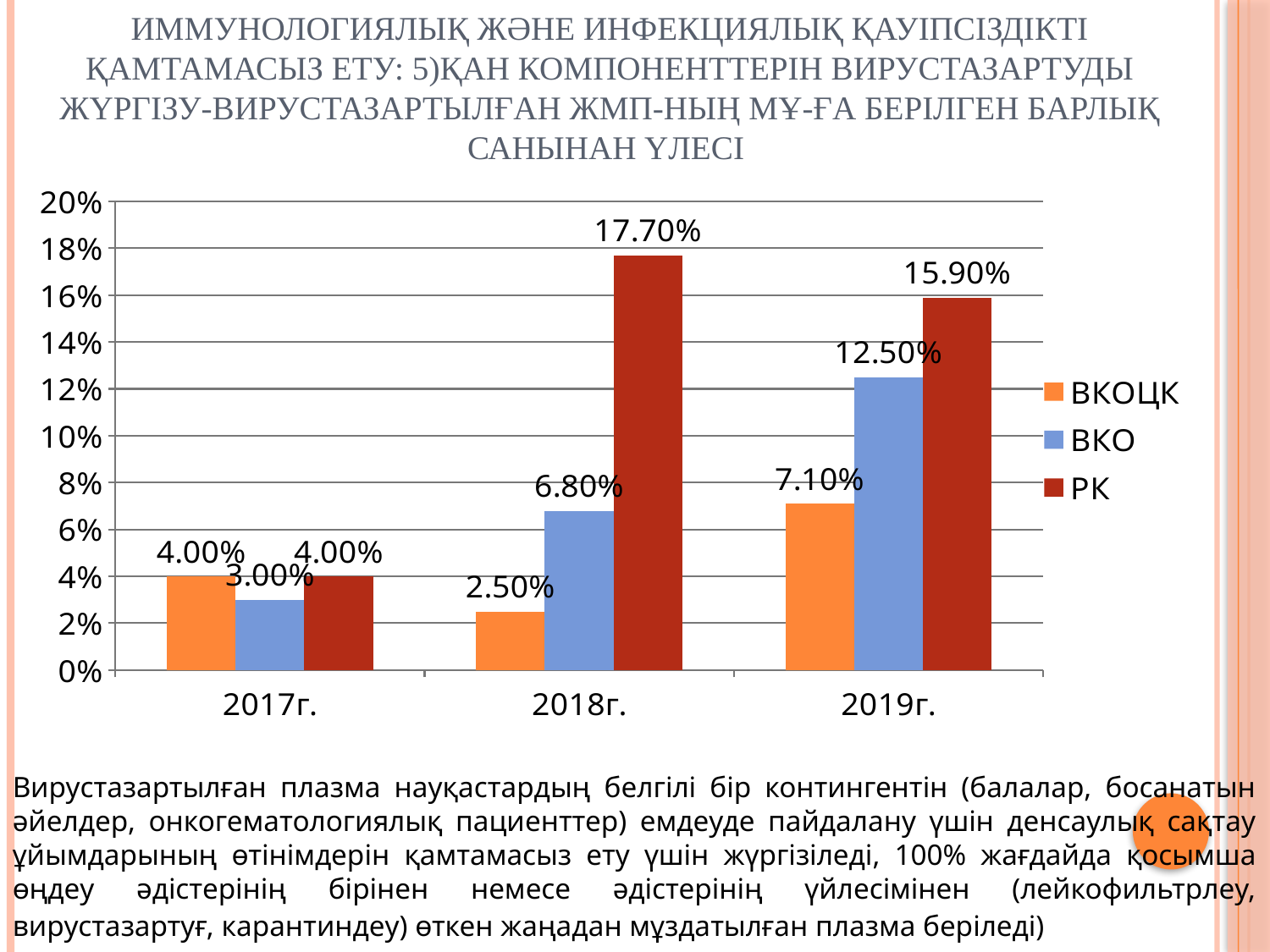
Which is larger in 2018г., the value for ВКО or the value for ВКОЦК? ВКО How many series does the legend list? 3 What is the difference between the РК value and the ВКО value in 2019г.? 3.40% What is the value for РК in 2018г.? 17.70% In which year is the value for ВКОЦК the lowest? 2018г. What is the value for ВКОЦК in 2018г.? 2.50% Does the value for ВКО rise or fall from 2017г. to 2019г.? rise How many years are shown on the x axis? 3 What is the value for ВКО in 2019г.? 12.50% In which year is the value for РК the highest? 2018г. What kind of chart is shown on the slide? bar chart What is the value for ВКО in 2017г.? 3.00%